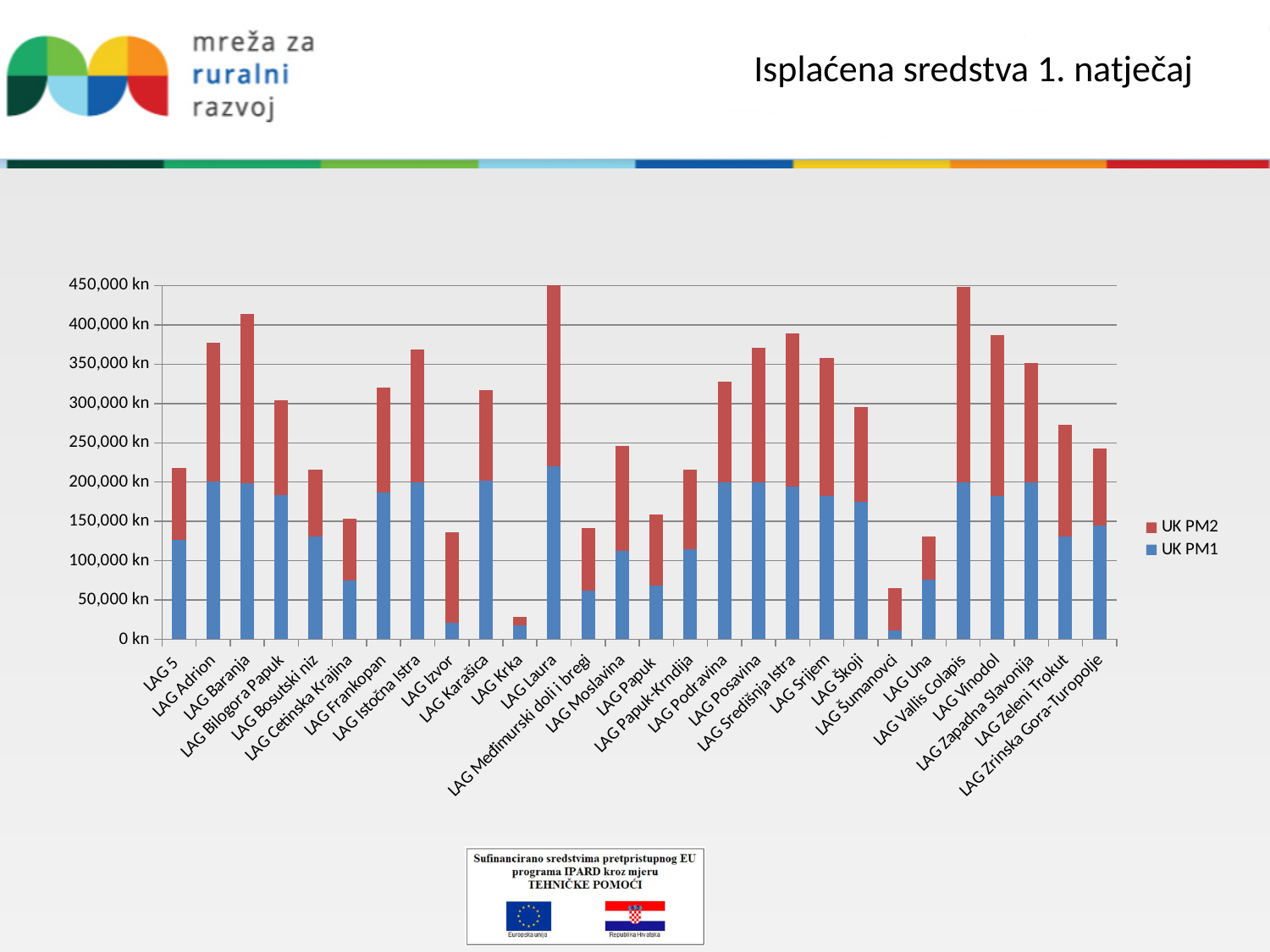
Is the total value for LAG Krka greater or less than 50,000 kn? less How many LAG categories are shown on the x axis? 28 Is the total value for LAG Šumanovci greater or less than 100,000 kn? less Is the total value for LAG Adrion greater or less than 350,000 kn? greater Which series is shown in blue in the legend? UK PM1 Which LAG has the lowest total bar? LAG Krka Which has the larger total bar, LAG Baranja or LAG Adrion? LAG Baranja Which has the smaller total bar, LAG Krka or LAG Šumanovci? LAG Krka What is the title of the slide/chart? Isplaćena sredstva 1. natječaj What kind of chart is shown on the slide? Stacked bar chart How many series does the legend list? 2